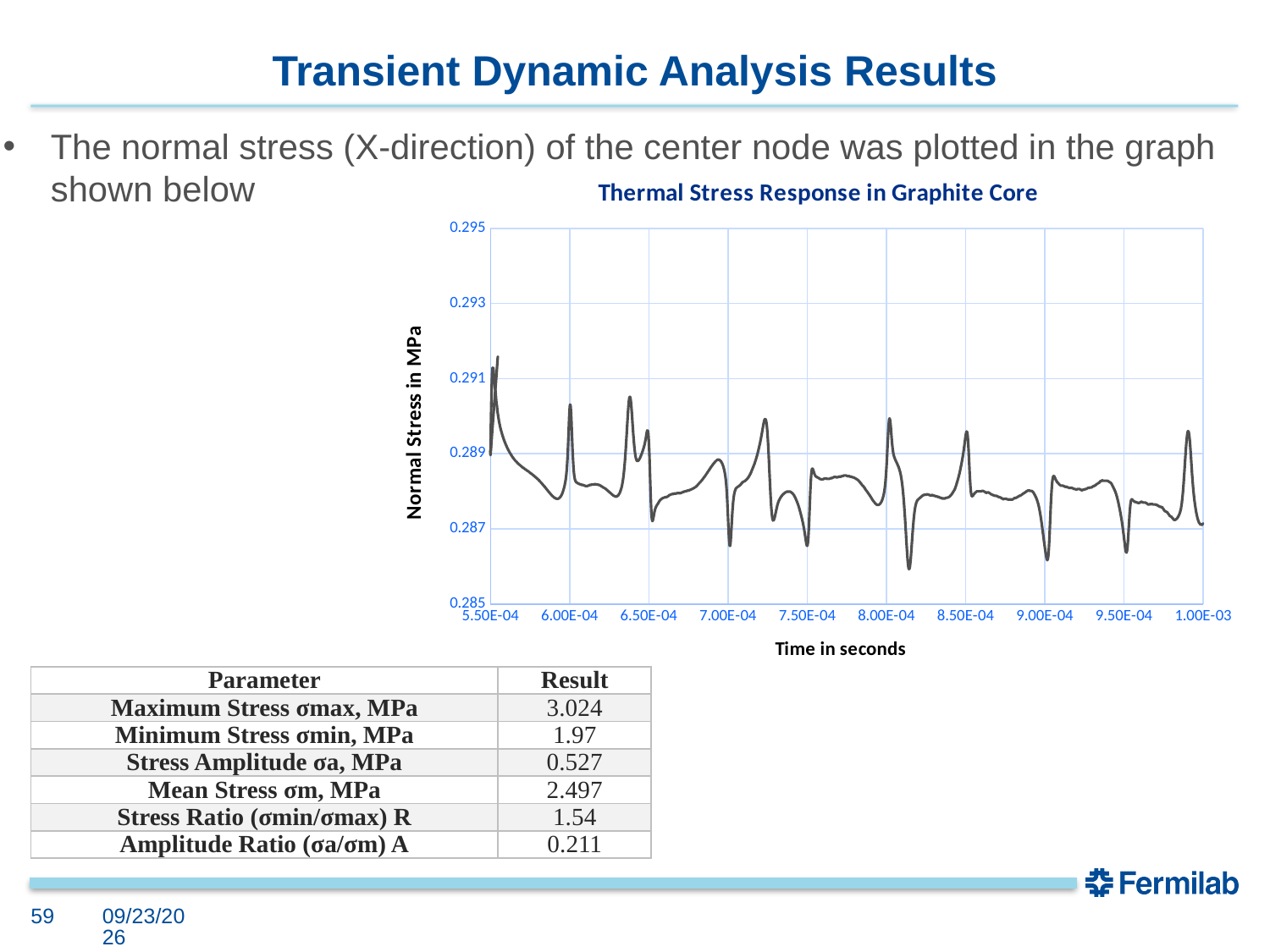
Is the highest point of the line greater or less than 0.293? less Is the lowest point of the line greater or less than 0.287? less Overall, does the stress line rise or fall from the left end of the x axis to the right end? fall Is the value of the line at 9.00E-04 seconds greater or less than 0.285? greater What is the label of the vertical axis of the chart? Normal Stress in MPa How many tick labels are shown on the vertical axis of the chart? 6 What kind of chart is shown on the slide? line chart What is the title of the chart on the slide? Thermal Stress Response in Graphite Core How many tick labels are shown on the horizontal axis of the chart? 10